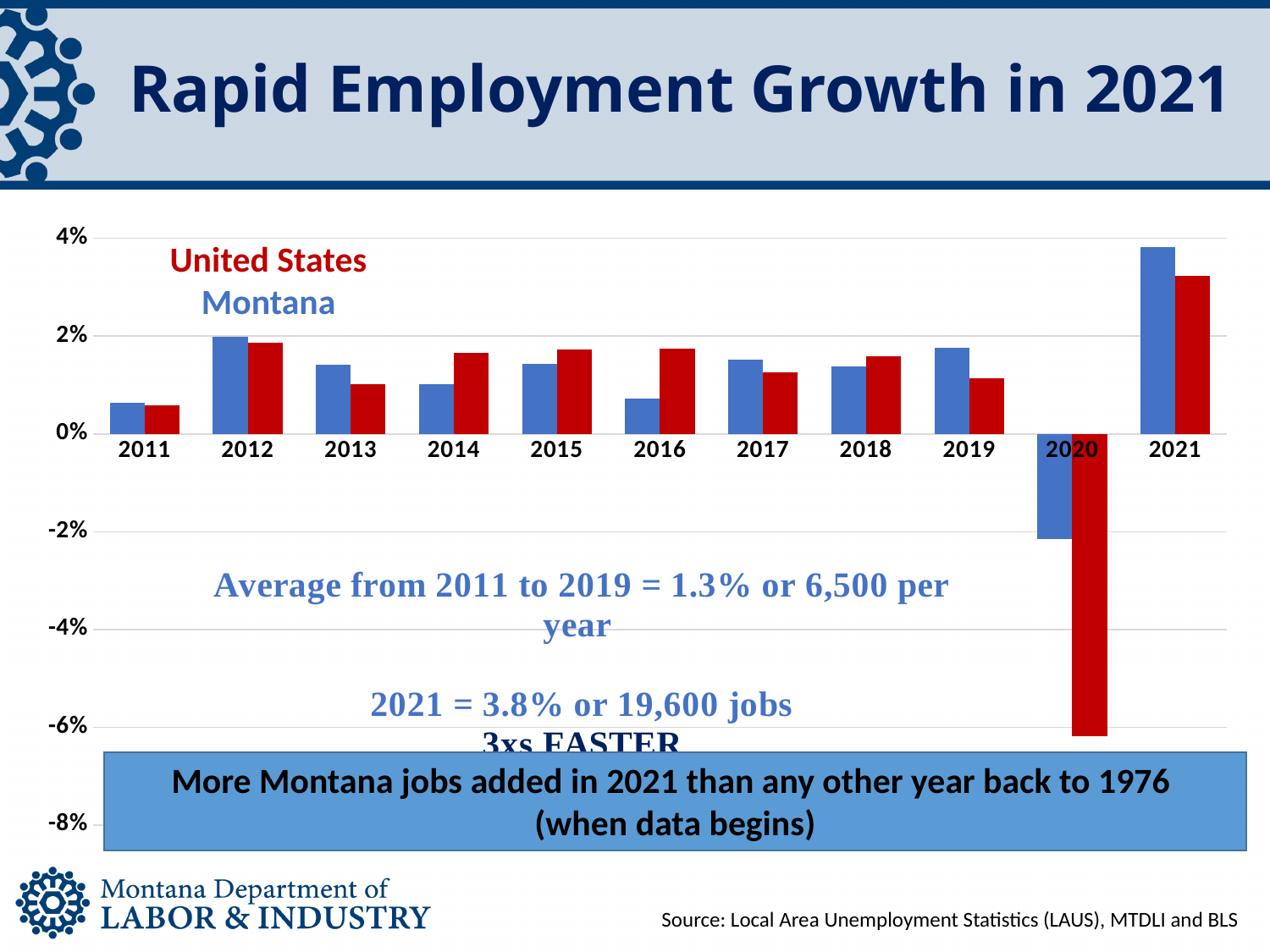
Is the Montana value for 2011 greater or less than 2%? less What kind of chart is shown on the slide? bar chart According to the text on the slide, what was Montana's employment growth in 2021? 3.8% Which colour represents Montana in the chart? blue In which year is the United States bar lowest? 2020 In which year is the Montana bar highest? 2021 In 2021, which is larger, the Montana value or the United States value? Montana How many series does the chart's legend list? 2 Is the United States value for 2021 greater or less than 2%? greater How many years are shown on the x axis of the chart? 11 In 2016, which is larger, the United States value or the Montana value? United States Is the United States value for 2020 greater or less than -4%? less